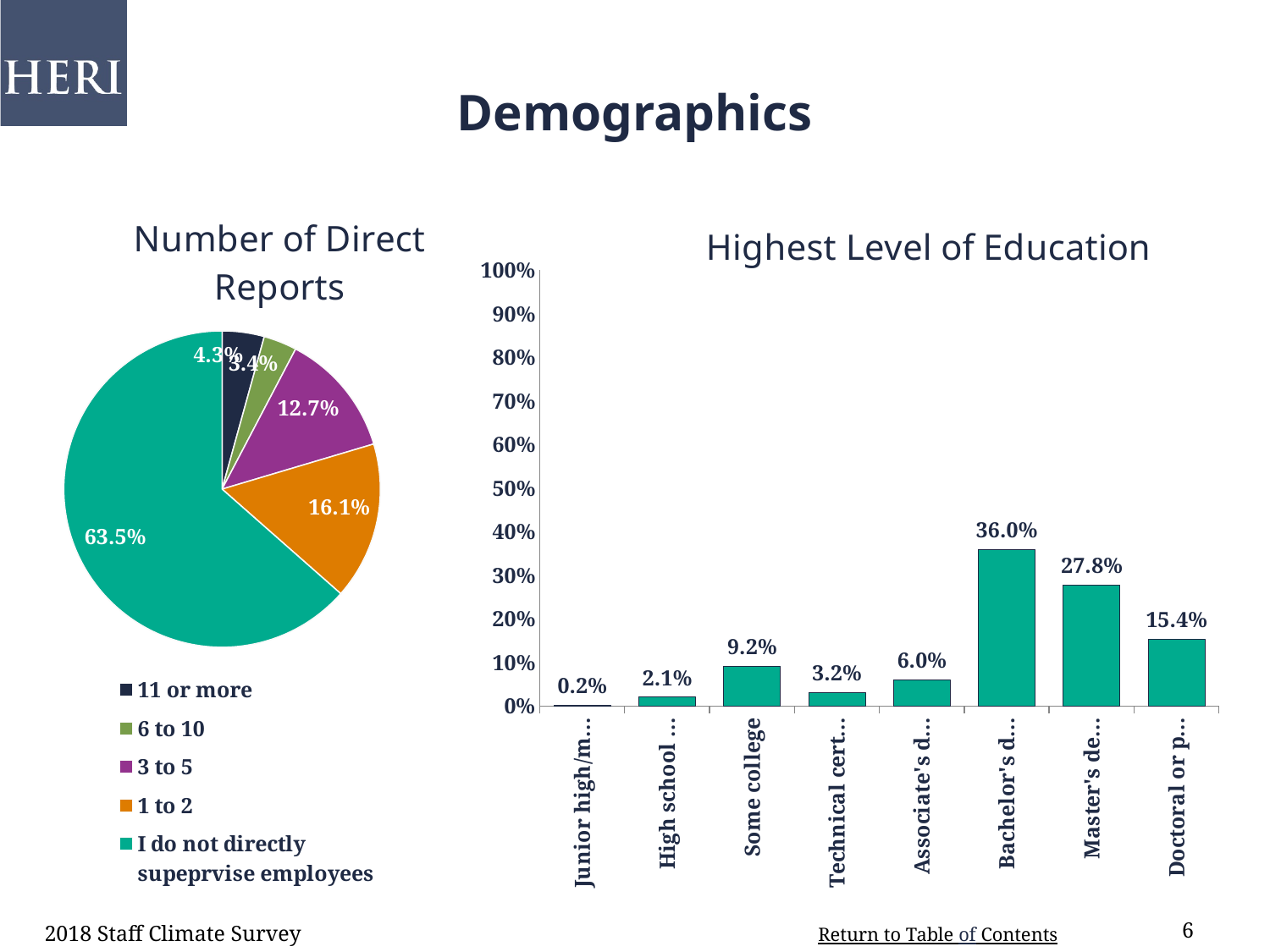
In the Highest Level of Education chart, which category has the lowest value? Junior high/m... In the Highest Level of Education chart, what is the difference between the Bachelor's degree bar and the Master's degree bar? 8.2% In the Number of Direct Reports pie chart, how many categories does the legend list? 5 In the Highest Level of Education chart, how many bars are plotted? 8 In the Number of Direct Reports pie chart, what share is labelled for the '3 to 5' slice? 12.7% In the Number of Direct Reports pie chart, what is the difference between the '1 to 2' slice and the '3 to 5' slice? 3.4% In the Number of Direct Reports pie chart, which category has the largest slice? I do not directly supeprvise employees In the Highest Level of Education chart, what is the value for Some college? 9.2% What kind of chart is the Highest Level of Education chart? Bar chart In the Number of Direct Reports pie chart, what share is labelled for the '1 to 2' slice? 16.1% In the Highest Level of Education chart, which is larger: the Master's degree bar or the Doctoral bar? Master's degree In the Highest Level of Education chart, what is the value for the Bachelor's degree bar? 36.0%